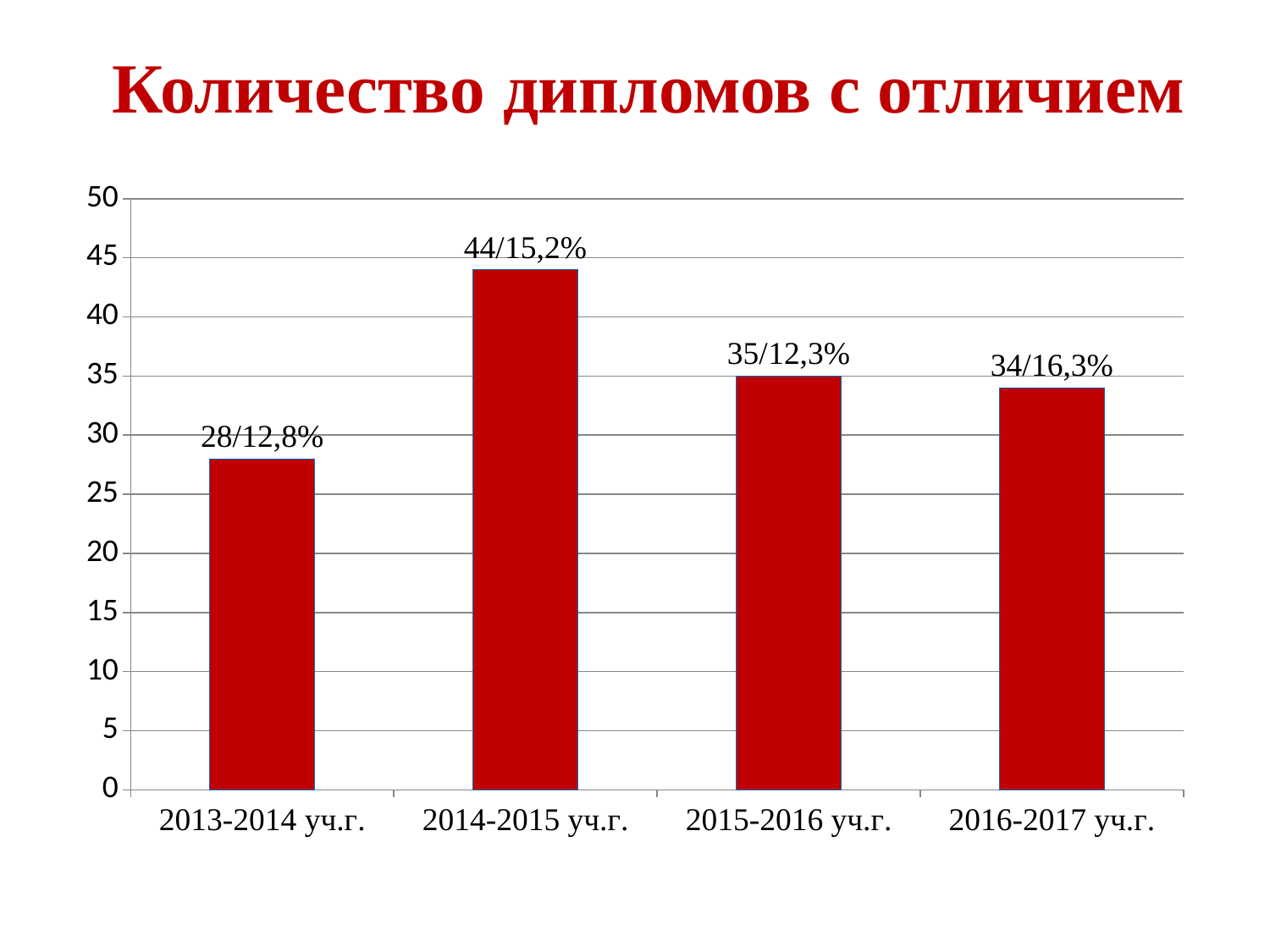
Which has more diplomas with distinction: 2015-2016 уч.г. or 2016-2017 уч.г.? 2015-2016 уч.г. What is the title of the slide? Количество дипломов с отличием How many academic years are shown on the chart? 4 What is the difference in the number of diplomas between 2014-2015 уч.г. and 2013-2014 уч.г.? 16 Which academic year has the lowest number of diplomas with distinction? 2013-2014 уч.г. How many diplomas with distinction are shown for 2015-2016 уч.г.? 35 What kind of chart is shown on the slide? bar chart Which academic year has the highest number of diplomas with distinction? 2014-2015 уч.г. What is the data label shown on the bar for 2014-2015 уч.г.? 44/15,2% What percentage is shown in the data label for 2016-2017 уч.г.? 16,3% Is the value for 2013-2014 уч.г. greater or less than 30? less What is the data label shown on the bar for 2013-2014 уч.г.? 28/12,8%